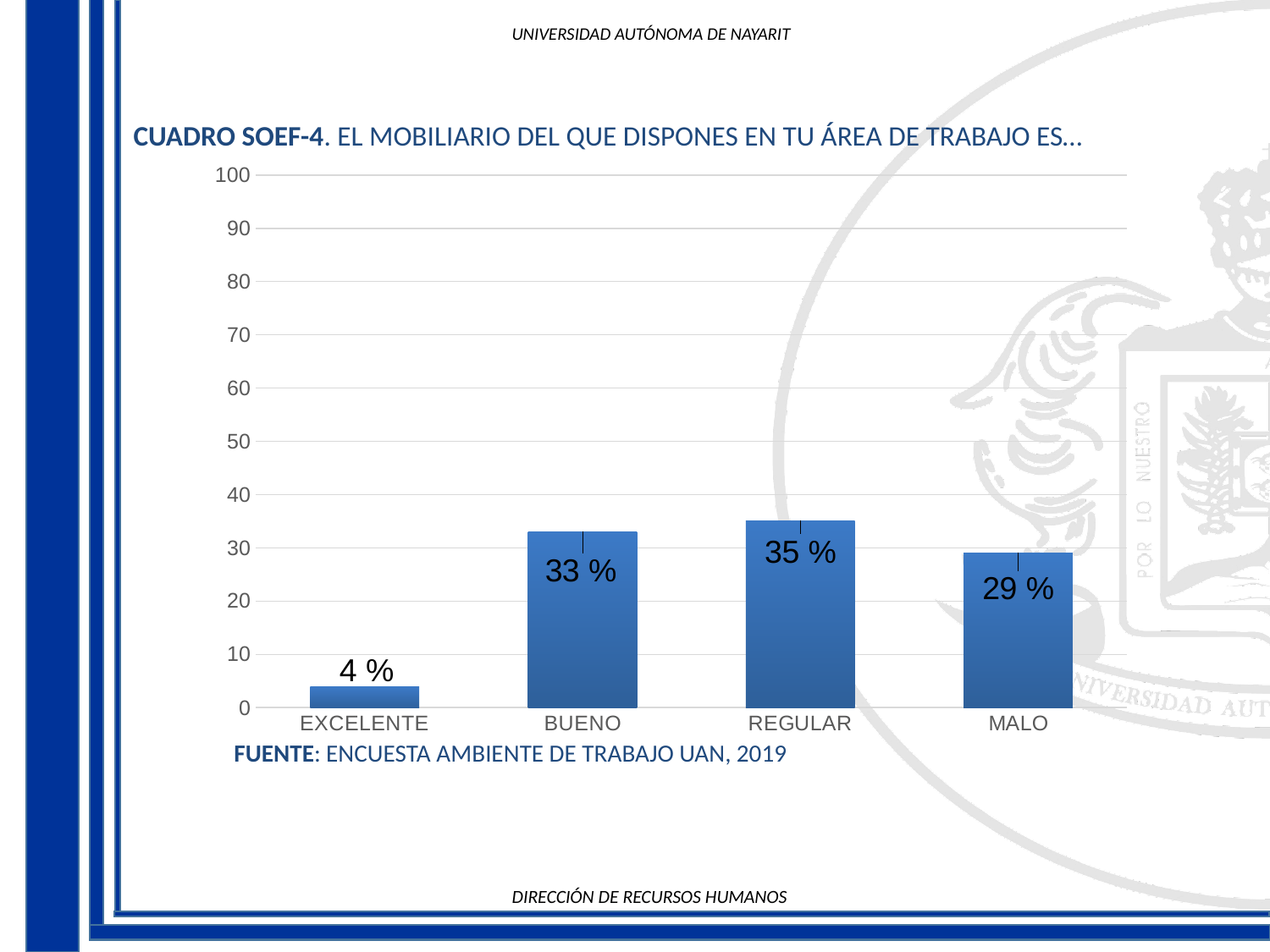
What is the difference between the values for REGULAR and MALO? 6 % What is the value for EXCELENTE? 4 % What is the difference between the values for BUENO and EXCELENTE? 29 % What is the value for MALO? 29 % How many categories are shown on the x axis? 4 Which category has the highest value? REGULAR What is the value for REGULAR? 35 % Is the value for MALO greater or less than 20? greater What is the value for BUENO? 33 % What kind of chart is shown on the slide? bar chart Which is larger, the value for BUENO or the value for MALO? BUENO Which category has the lowest value? EXCELENTE